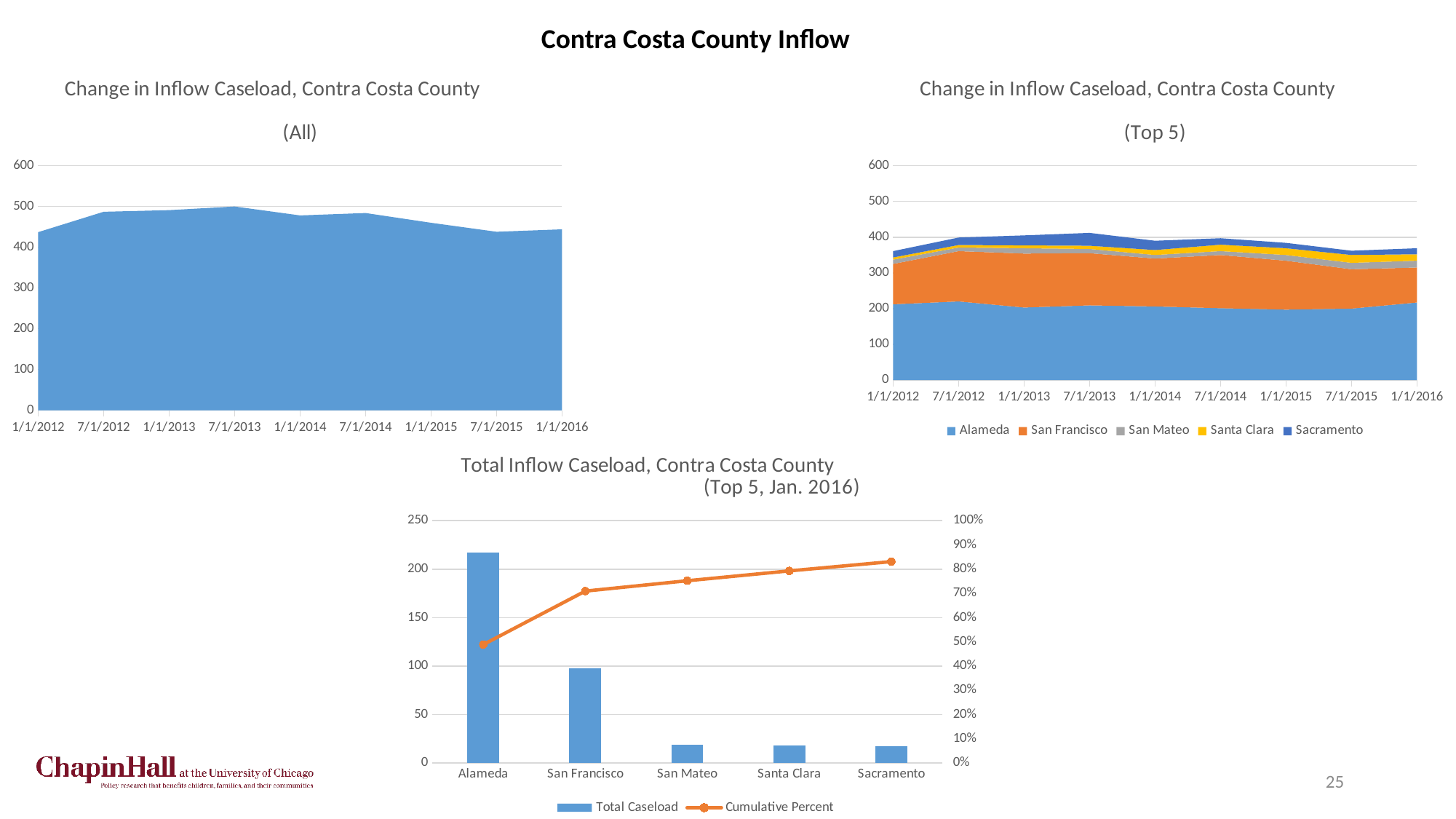
In the 'Change in Inflow Caseload, Contra Costa County (All)' chart, what kind of chart is shown? Area chart In the 'Change in Inflow Caseload, Contra Costa County (Top 5)' chart, which series forms the bottom layer of the stacked area? Alameda In the 'Total Inflow Caseload, Contra Costa County (Top 5, Jan. 2016)' chart, is the Cumulative Percent for Sacramento greater or less than 80%? greater In the 'Change in Inflow Caseload, Contra Costa County (All)' chart, is the value at 1/1/2012 greater or less than 400? greater In the 'Total Inflow Caseload, Contra Costa County (Top 5, Jan. 2016)' chart, which county has the highest Total Caseload? Alameda In the 'Total Inflow Caseload, Contra Costa County (Top 5, Jan. 2016)' chart, which is larger, the Total Caseload for Alameda or for San Francisco? Alameda In the 'Change in Inflow Caseload, Contra Costa County (Top 5)' chart, how many series does the legend list? 5 In the 'Total Inflow Caseload, Contra Costa County (Top 5, Jan. 2016)' chart, is the Total Caseload for Alameda greater or less than 200? greater In the 'Change in Inflow Caseload, Contra Costa County (All)' chart, how many dates are labelled on the x axis? 9 In the 'Total Inflow Caseload, Contra Costa County (Top 5, Jan. 2016)' chart, does the Cumulative Percent line rise or fall from Alameda to Sacramento? Rise